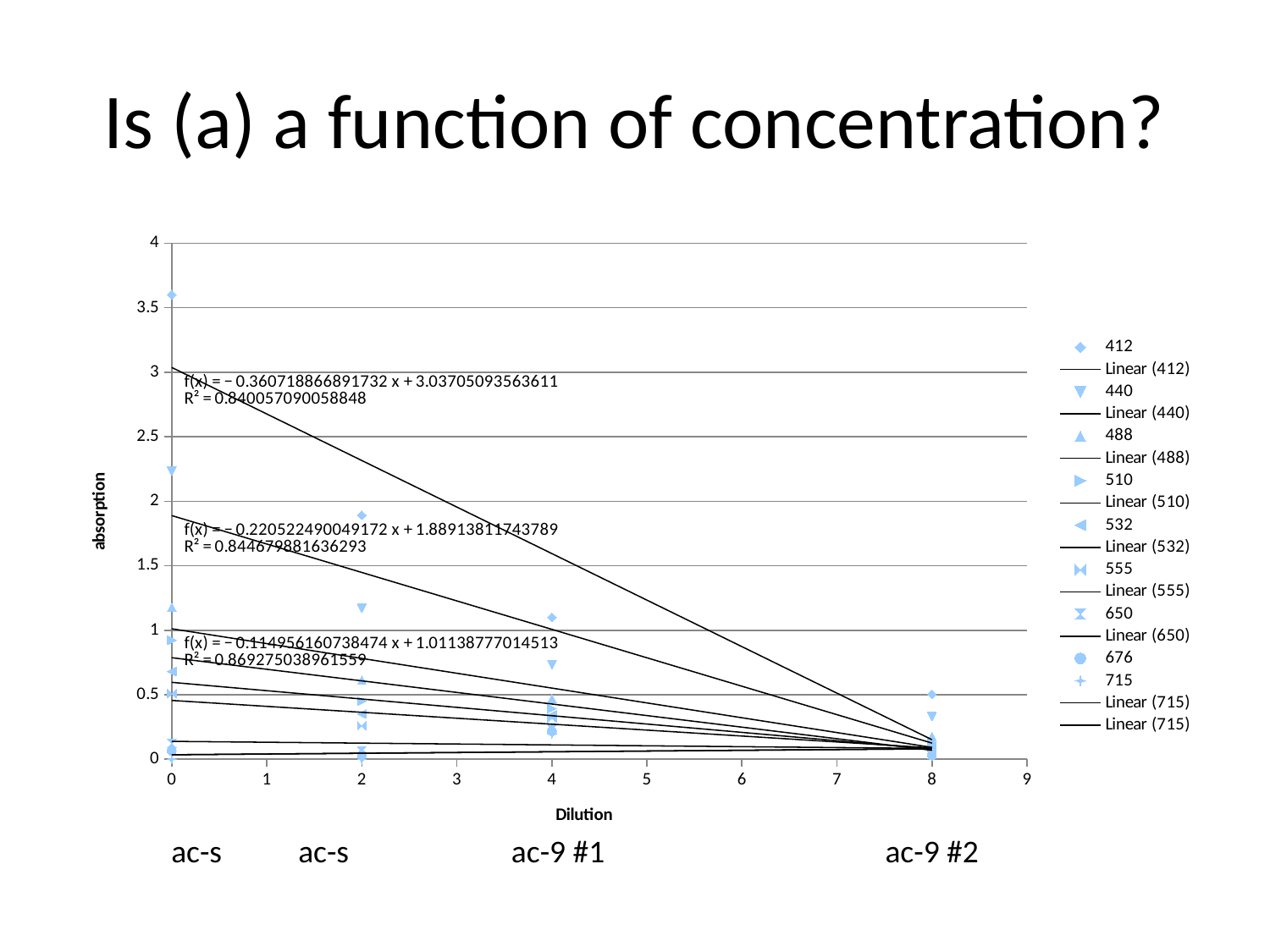
Is the absorption for series 440 at dilution 0 greater or less than 2? greater Which series has the highest absorption at dilution 0? 412 At dilution 4, which series has the larger absorption, 412 or 440? 412 Do the absorption values rise or fall as dilution increases? fall What is the title of the y axis? absorption How many wavelength data series (excluding the Linear trendlines) does the legend list? 9 At how many distinct dilution values are data points plotted? 4 What kind of chart is shown on the slide? scatter chart with linear trendlines Is the absorption for series 412 at dilution 0 greater or less than 3? greater How many entries does the legend list? 18 Is the absorption for series 440 at dilution 4 greater or less than 1? less What is the title of the x axis? Dilution